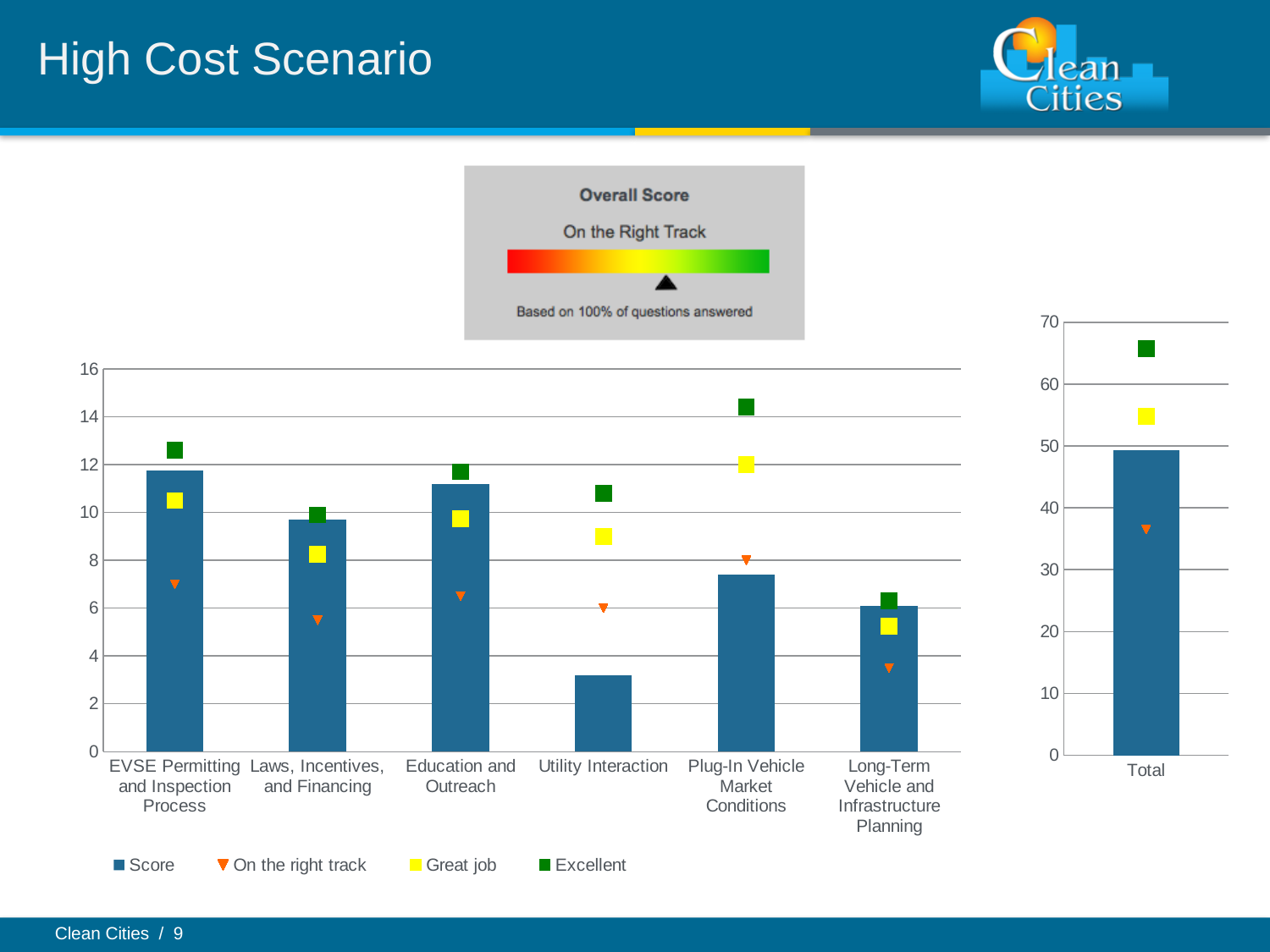
In the left chart, which has the larger Score bar: Laws, Incentives, and Financing or Long-Term Vehicle and Infrastructure Planning? Laws, Incentives, and Financing What kind of chart is the left chart? bar chart In the left chart, is the Score for Utility Interaction greater or less than 4? less In the right chart, is the Score bar for Total greater or less than 40? greater In the left chart, is the Score for Plug-In Vehicle Market Conditions greater or less than 8? less How many categories are shown on the x axis of the left chart? 6 In the left chart, which category has the lowest Score bar? Utility Interaction How many series does the legend of the left chart list? 4 What are the four legend entries of the left chart? Score, On the right track, Great job, Excellent In the left chart, which has the larger Score bar: Utility Interaction or Plug-In Vehicle Market Conditions? Plug-In Vehicle Market Conditions